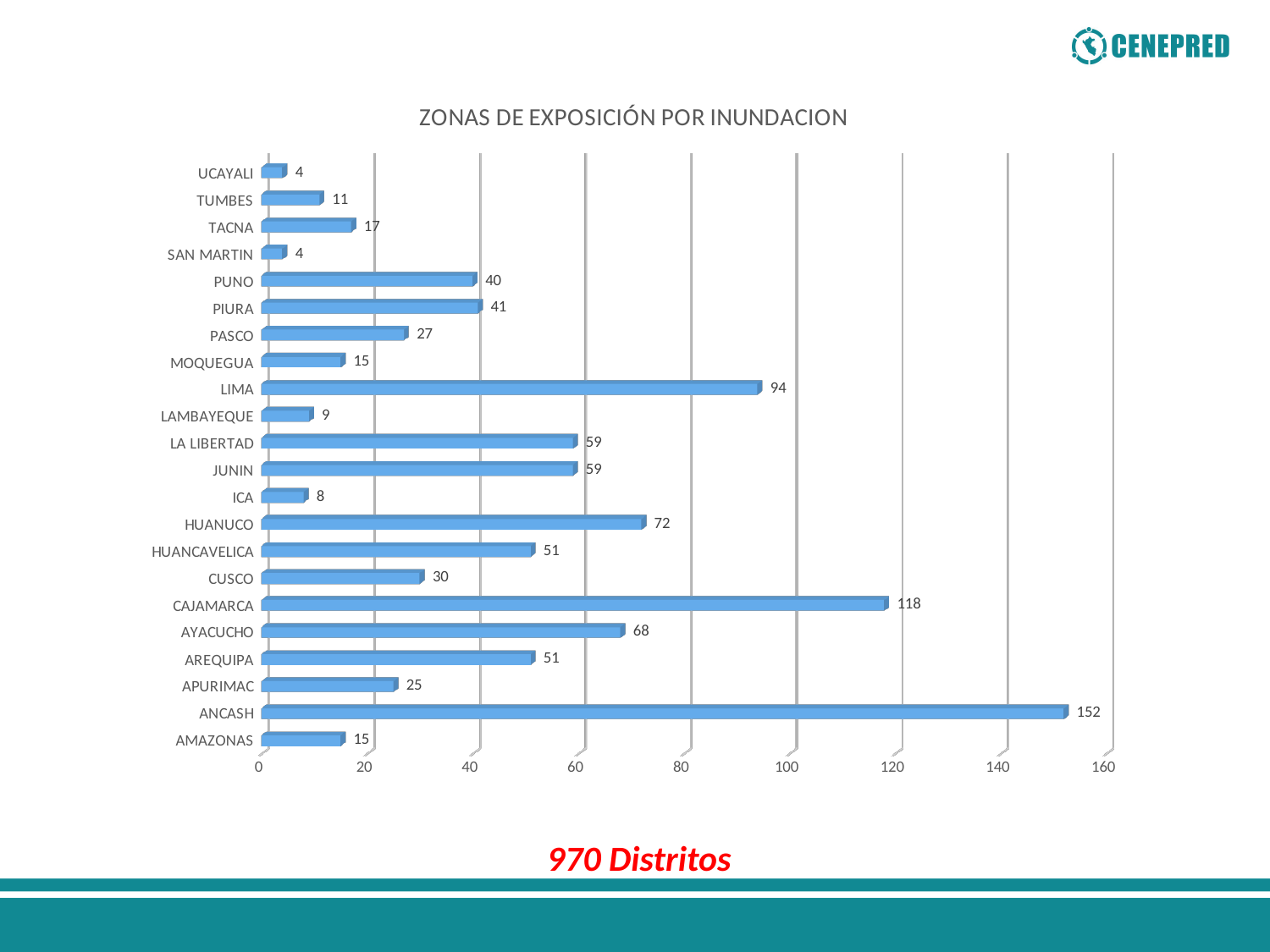
What kind of chart is shown on the slide? bar chart Which is larger, the value for HUANUCO or the value for AYACUCHO? HUANUCO Which category has the highest value? ANCASH What is the difference between the values for PIURA and PUNO? 1 How many categories are shown on the chart? 22 Is the value for LIMA greater or less than 80? greater What is the difference between the values for ANCASH and CAJAMARCA? 34 What is the value for LIMA? 94 What total number of districts is stated below the chart? 970 Distritos What is the value for HUANCAVELICA? 51 What is the title of the chart? ZONAS DE EXPOSICIÓN POR INUNDACION What is the value for CAJAMARCA? 118